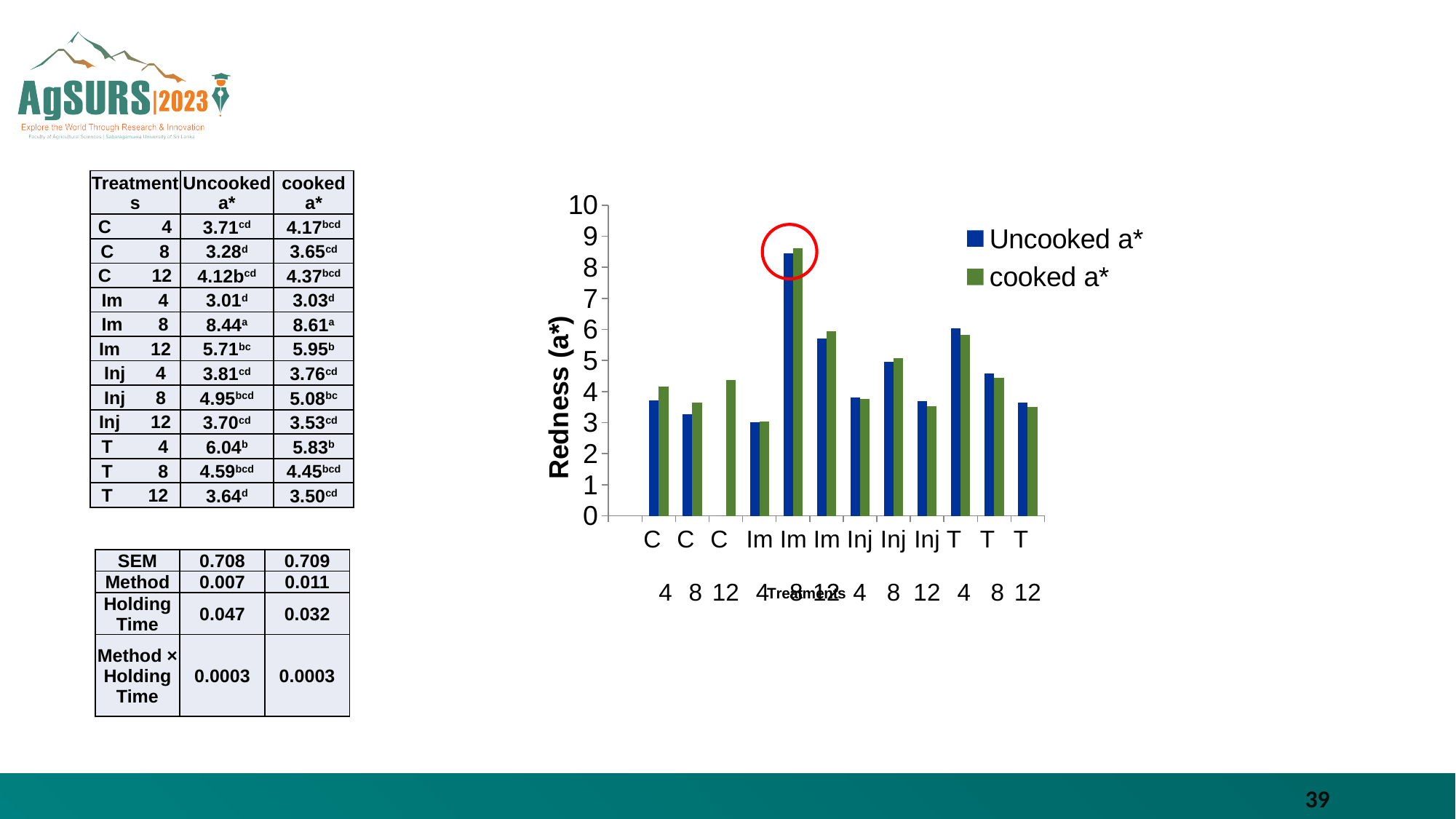
What kind of chart is shown on the slide? bar chart For treatment C 4, which bar is taller: Uncooked a* or cooked a*? cooked a* Which is larger in the chart: the Uncooked a* bar for Im 8 or the Uncooked a* bar for T 4? Im 8 Is the cooked a* value for Inj 12 greater or less than 4? less How many series does the chart legend list? 2 Which treatment group has the lowest cooked a* bar in the chart? Im 4 How many treatment groups are shown along the x axis of the chart? 12 What is the label on the vertical axis of the chart? Redness (a*) Which treatment group has the highest Uncooked a* bar in the chart? Im 8 Is the cooked a* value for C 12 greater or less than 4? greater Which treatment group has the highest cooked a* bar in the chart? Im 8 Is the Uncooked a* value for Im 8 greater or less than 8? greater